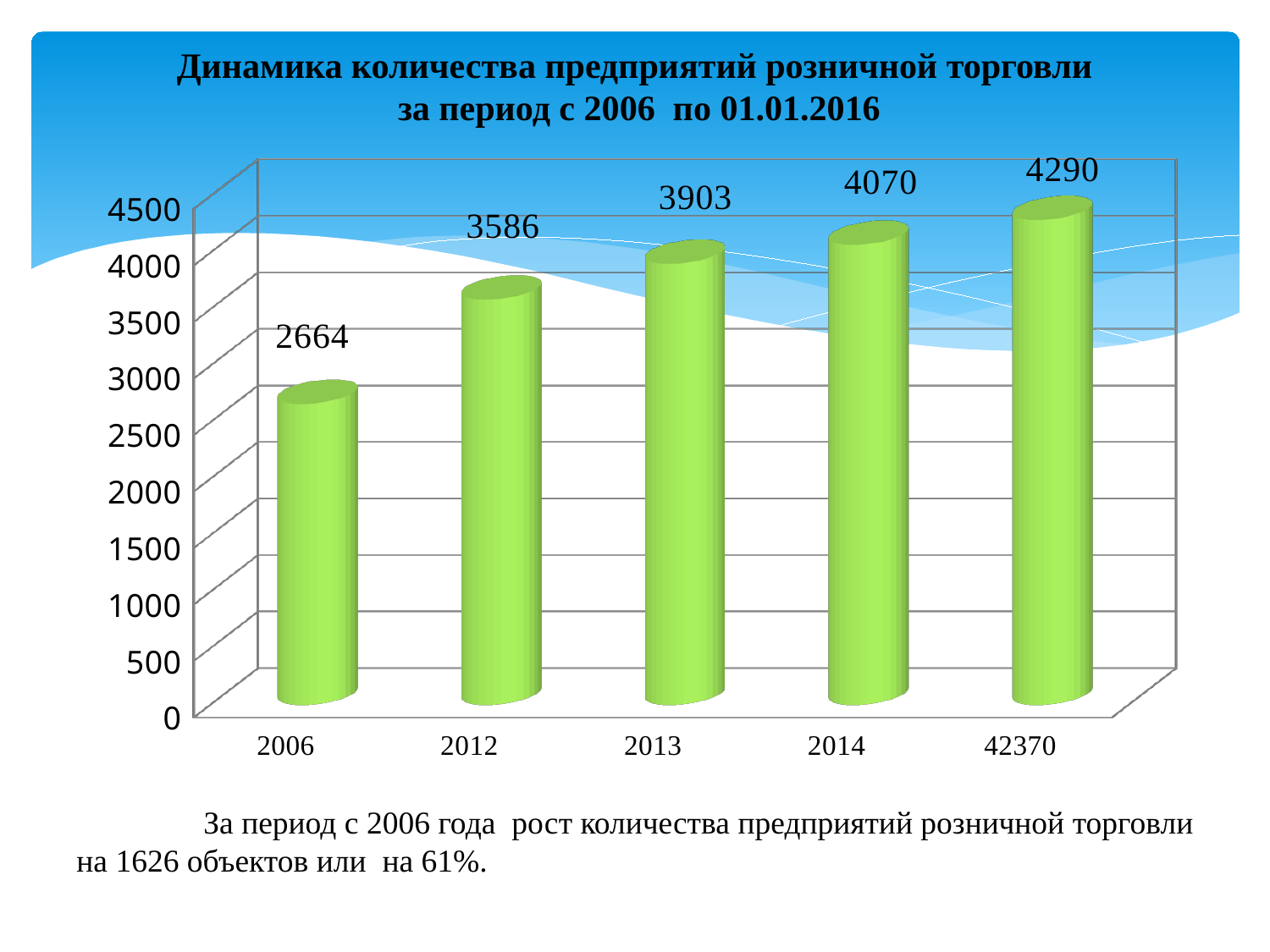
What is the value for the category labelled 42370? 4290 What kind of chart is shown? bar chart Which category has the lowest value? 2006 How many categories are shown on the x axis? 5 What is the difference between the values for 42370 and 2006? 1626 Do the values rise or fall from left to right along the x axis? rise What is the difference between the values for 2014 and 2012? 484 Which category has the highest value? 42370 What is the value for 2006? 2664 Which is larger, the value for 2013 or the value for 2014? 2014 Is the value for 2012 greater or less than 3500? greater What is the value for 2013? 3903